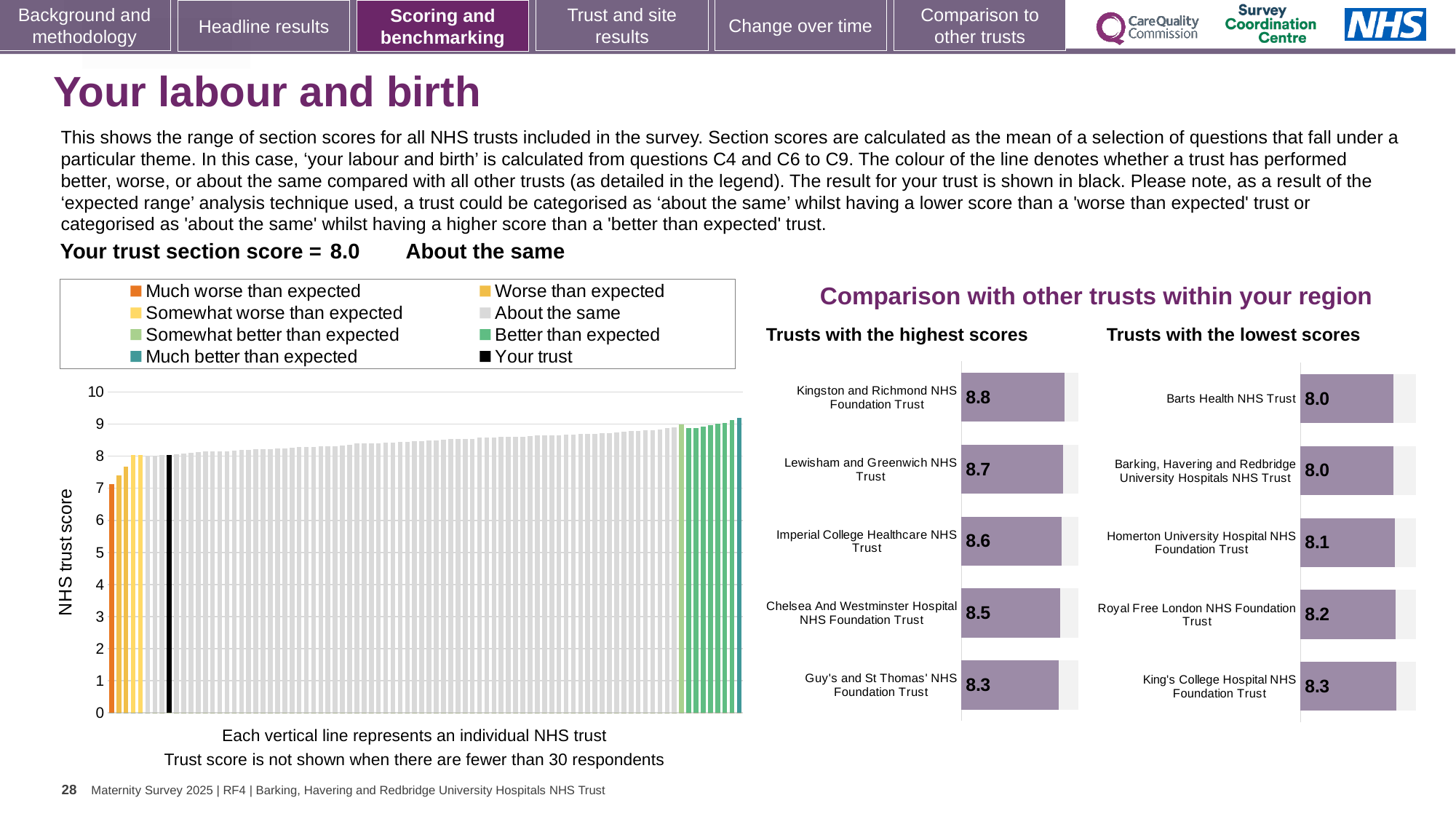
In the 'Trusts with the lowest scores' chart, which has the larger score: Barts Health NHS Trust or King's College Hospital NHS Foundation Trust? King's College Hospital NHS Foundation Trust In the 'Trusts with the lowest scores' chart, what is the score for Homerton University Hospital NHS Foundation Trust? 8.1 What kind of chart is the main chart with the 'NHS trust score' axis? Bar chart In the main 'NHS trust score' chart, is the value of the highest bar greater or less than 9? greater In the 'Trusts with the highest scores' chart, what is the difference between the scores of Kingston and Richmond NHS Foundation Trust and Guy's and St Thomas' NHS Foundation Trust? 0.5 How many trusts are shown in the 'Trusts with the lowest scores' chart? 5 In the 'Trusts with the highest scores' chart, what is the score for Imperial College Healthcare NHS Trust? 8.6 How many entries does the legend of the main 'NHS trust score' chart list? 8 In the 'Trusts with the lowest scores' chart, what is the score for Royal Free London NHS Foundation Trust? 8.2 In the 'Trusts with the highest scores' chart, which trust has the lowest score? Guy's and St Thomas' NHS Foundation Trust In the 'Trusts with the highest scores' chart, which trust has the highest score? Kingston and Richmond NHS Foundation Trust In the 'Trusts with the highest scores' chart, what is the score for Kingston and Richmond NHS Foundation Trust? 8.8